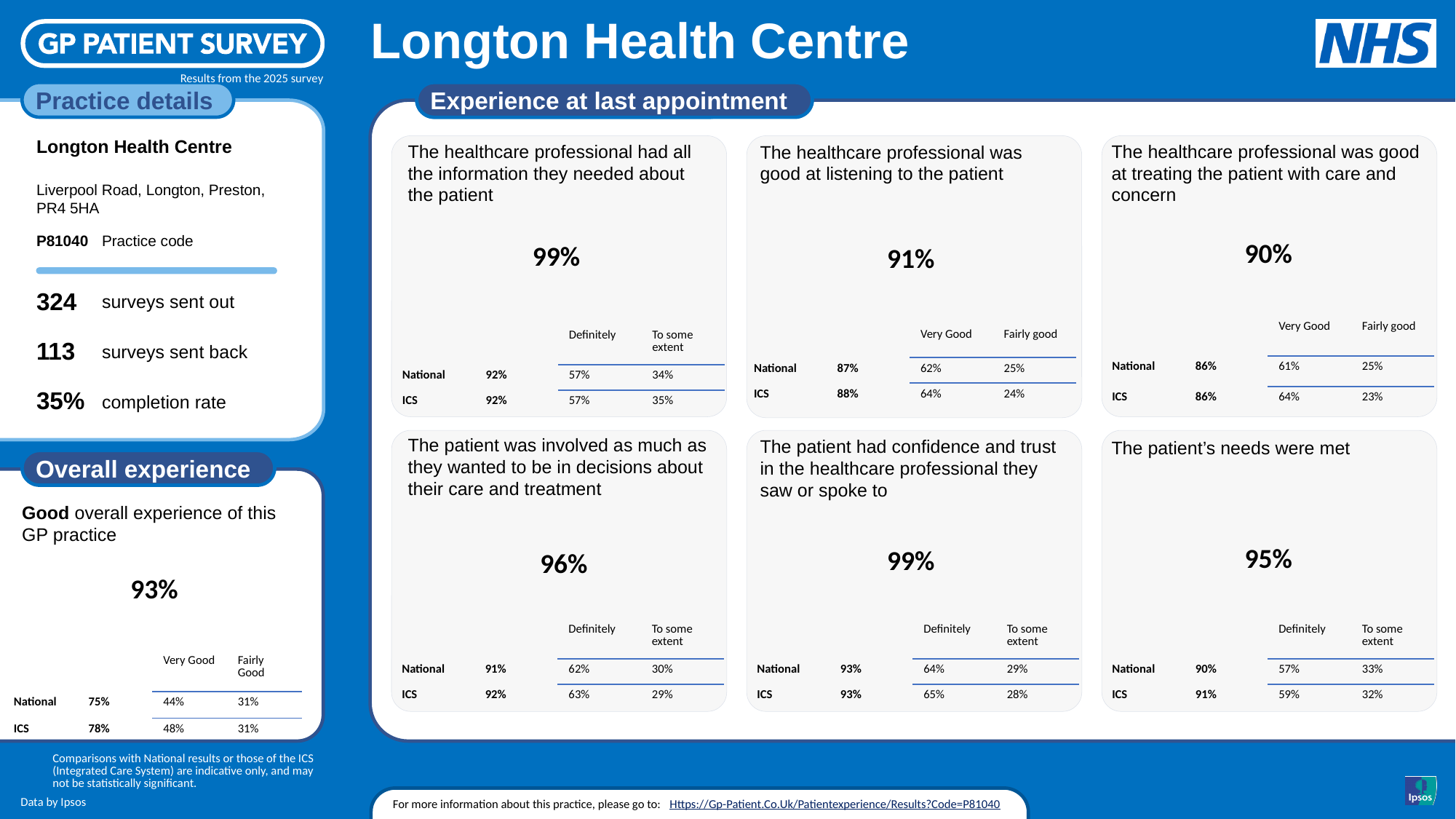
In the 'Good overall experience of this GP practice' panel, what is the practice's percentage? 93% In the 'Good overall experience of this GP practice' panel, what is the ICS 'Very Good' percentage? 48% In the 'The healthcare professional had all the information they needed about the patient' panel, what is the practice's percentage? 99% How many question panels are shown under 'Experience at last appointment'? 6 In the 'The patient's needs were met' panel, what is the difference between the practice's percentage and the National percentage? 5% In the 'Good overall experience of this GP practice' panel, what is the difference between the ICS and National percentages? 3% In the 'Good overall experience of this GP practice' panel, what is the National percentage? 75% In the 'The healthcare professional was good at listening to the patient' panel, what is the National 'Very Good' percentage? 62% In the 'The healthcare professional was good at treating the patient with care and concern' panel, what is the ICS percentage? 86% In the 'The patient had confidence and trust in the healthcare professional they saw or spoke to' panel, which is larger: the ICS 'Definitely' percentage or the ICS 'To some extent' percentage? Definitely Across the six 'Experience at last appointment' panels, which question has the lowest practice percentage? The healthcare professional was good at treating the patient with care and concern In the 'The patient was involved as much as they wanted to be in decisions about their care and treatment' panel, what is the practice's percentage? 96%